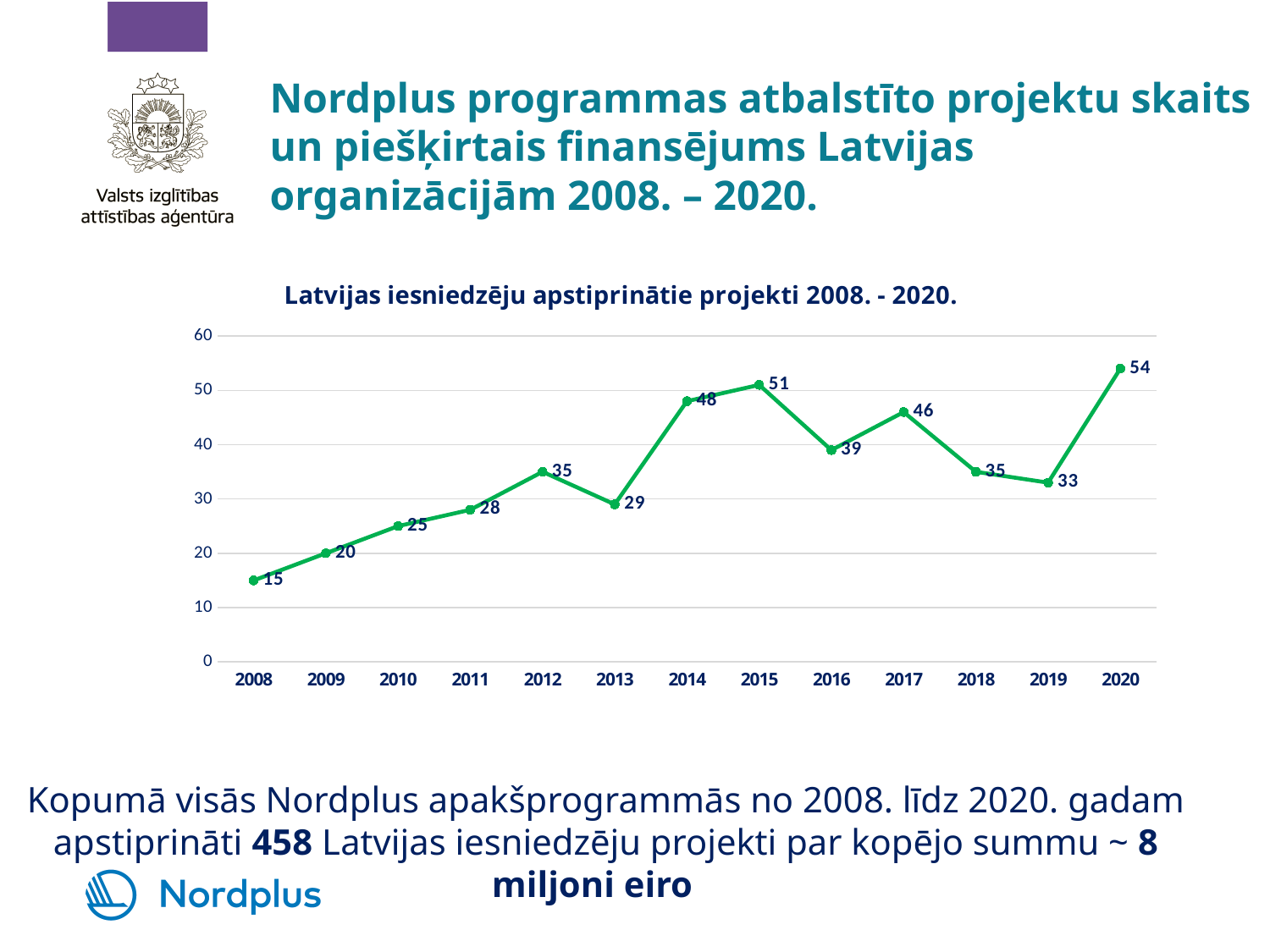
Which is larger, the value for 2013 or the value for 2012? 2012 What is the title of the chart? Latvijas iesniedzēju apstiprinātie projekti 2008. - 2020. What is the value for 2014? 48 What is the value for 2017? 46 Which year has the highest value? 2020 What is the difference between the values for 2015 and 2016? 12 How many years are plotted on the chart? 13 What kind of chart is shown on the slide? line chart What is the value for 2008? 15 What is the difference between the values for 2020 and 2019? 21 Which year has the lowest value? 2008 Is the value for 2015 greater or less than 50? greater